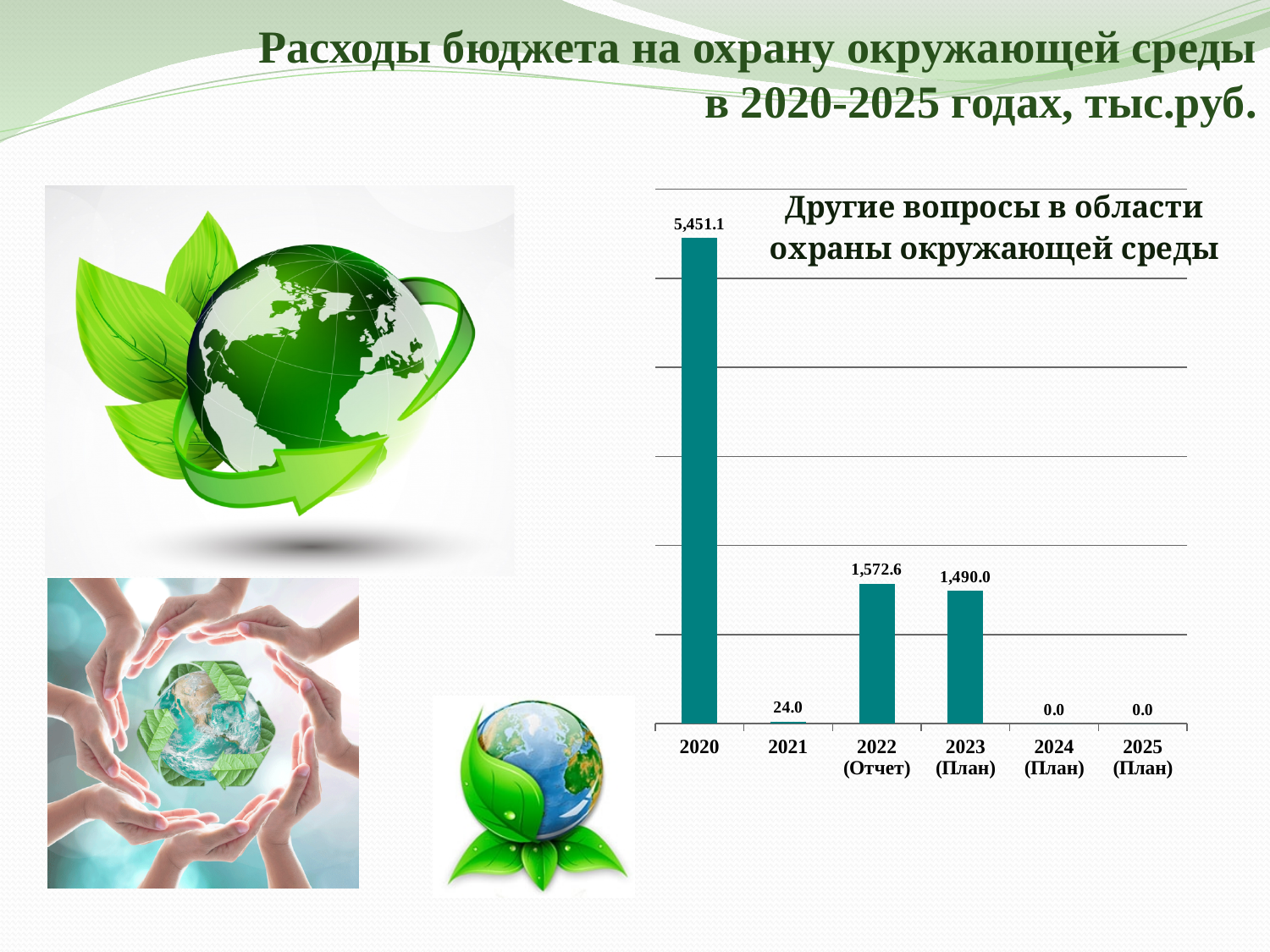
What is the value for 2025 (План) in the chart? 0.0 What is the value for 2021 in the chart? 24.0 Which year has the highest value in the chart? 2020 What is the value for 2022 (Отчет) in the chart? 1,572.6 What is the title of the chart? Другие вопросы в области охраны окружающей среды What is the difference between the values for 2022 (Отчет) and 2023 (План)? 82.6 What kind of chart is shown on the slide? Bar chart How many years are shown on the x axis of the chart? 6 What is the difference between the values for 2020 and 2021? 5,427.1 Which is larger, the value for 2022 (Отчет) or the value for 2023 (План)? 2022 (Отчет) What is the value for 2020 in the chart? 5,451.1 What is the value for 2023 (План) in the chart? 1,490.0